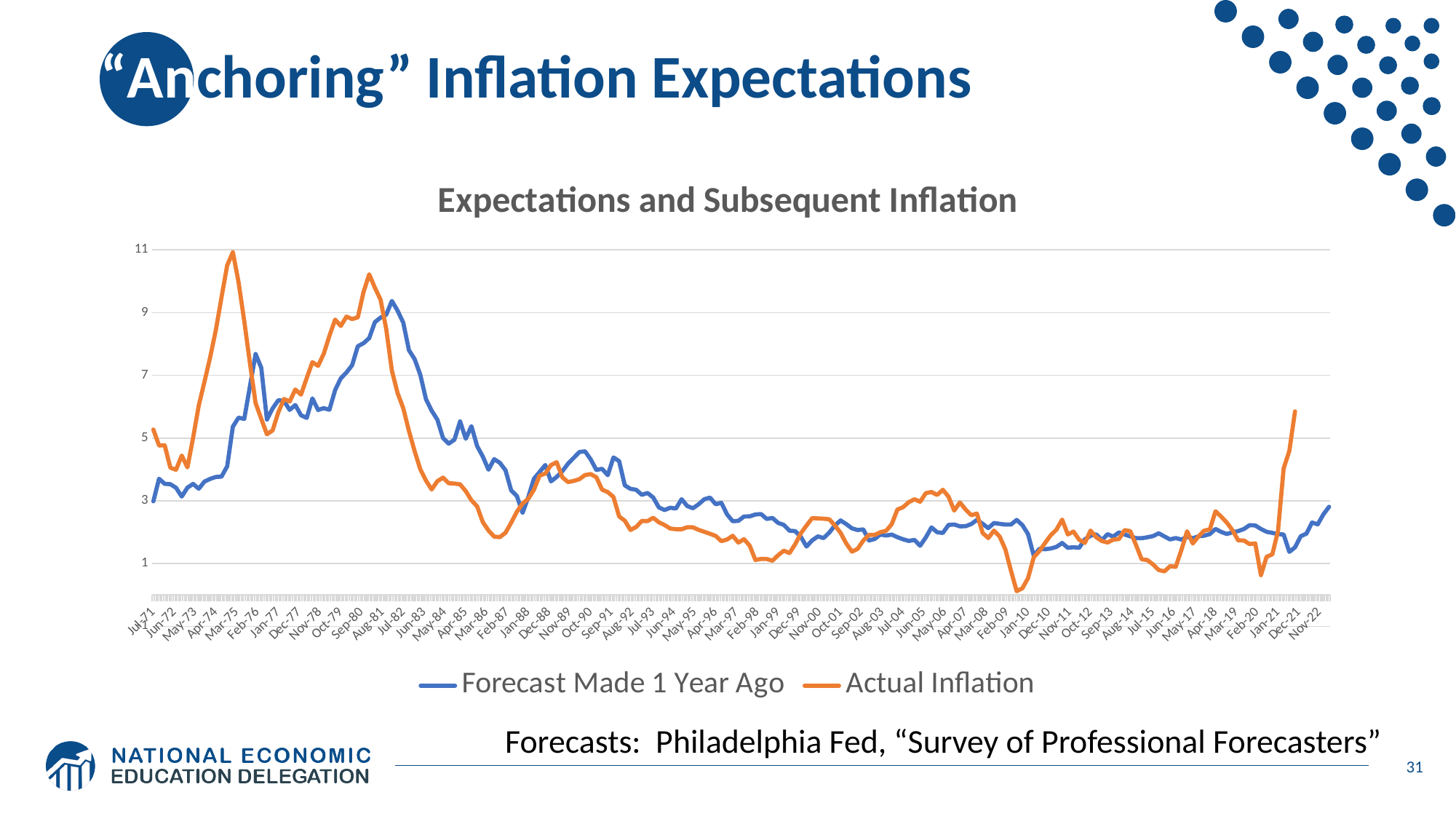
Is the value of Forecast Made 1 Year Ago at Nov-22 greater or less than 5? less What is the title of the chart? Expectations and Subsequent Inflation Is the peak value of Actual Inflation around Mar-75 greater or less than 9? greater Which series is drawn in orange? Actual Inflation What kind of chart is shown on the slide? Line chart Is the value of Actual Inflation at Dec-21 greater or less than 5? greater Which series reaches the highest value anywhere on the chart? Actual Inflation How many series does the legend list? 2 Around Jan-10, which series is higher, Forecast Made 1 Year Ago or Actual Inflation? Forecast Made 1 Year Ago Around Mar-75, which series is higher, Forecast Made 1 Year Ago or Actual Inflation? Actual Inflation Does Actual Inflation rise or fall between Feb-20 and Dec-21? Rise